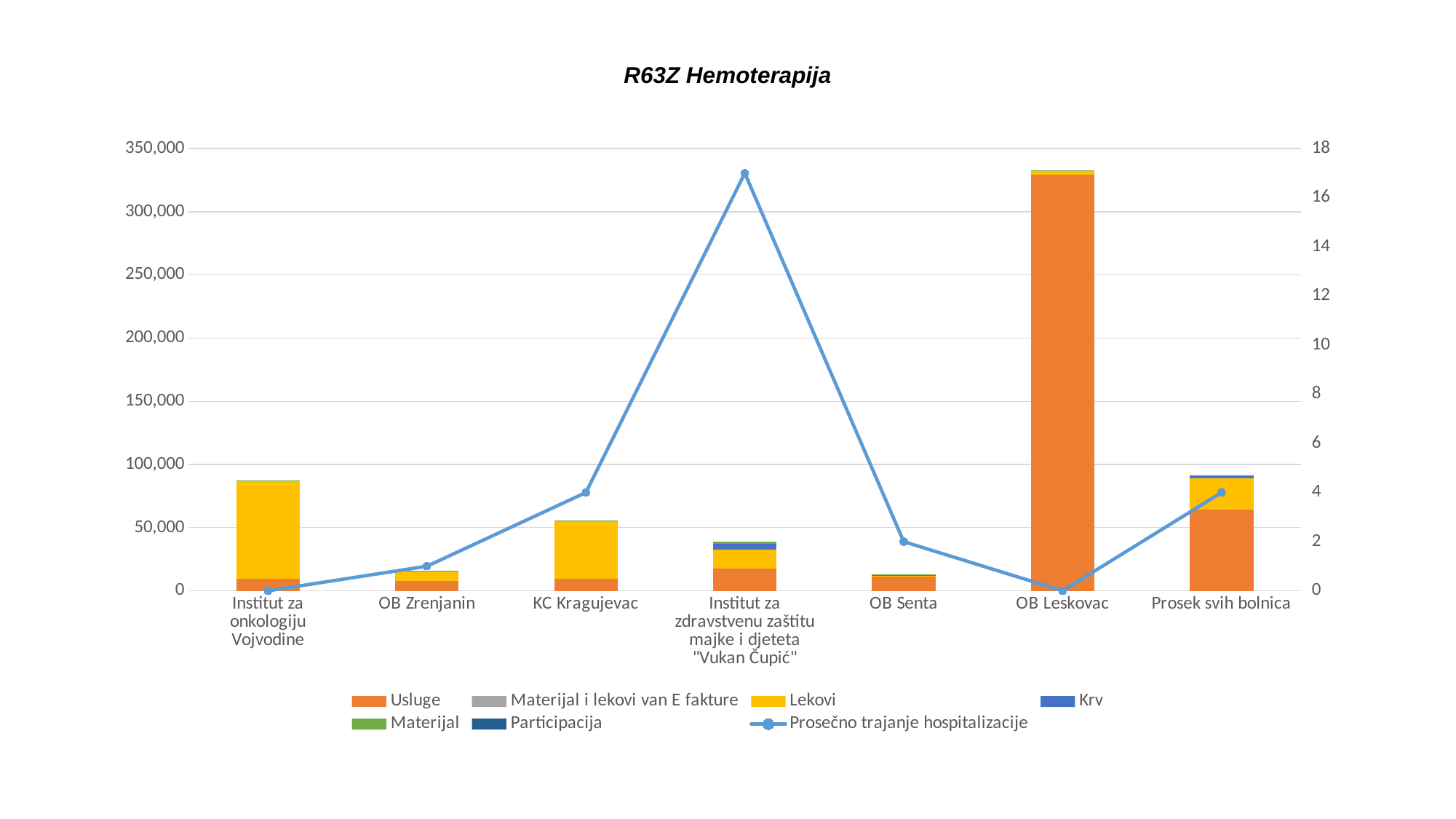
What is the title of the chart? R63Z Hemoterapija Which has the larger total stacked bar, OB Leskovac or Institut za onkologiju Vojvodine? OB Leskovac Is the total stacked bar for OB Leskovac greater or less than 300,000? greater How many categories are shown on the x axis? 7 Which category has the tallest stacked bar? OB Leskovac Which category has the highest value for Prosečno trajanje hospitalizacije? Institut za zdravstvenu zaštitu majke i djeteta "Vukan Čupić" Is the total stacked bar for Institut za onkologiju Vojvodine greater or less than 100,000? less Which has the higher Prosečno trajanje hospitalizacije value, KC Kragujevac or OB Senta? KC Kragujevac Is the Prosečno trajanje hospitalizacije value for Institut za zdravstvenu zaštitu majke i djeteta "Vukan Čupić" greater or less than 16? greater Which series is shown as a line with markers? Prosečno trajanje hospitalizacije What kind of chart is this? Stacked bar chart combined with a line chart How many series does the legend list? 7